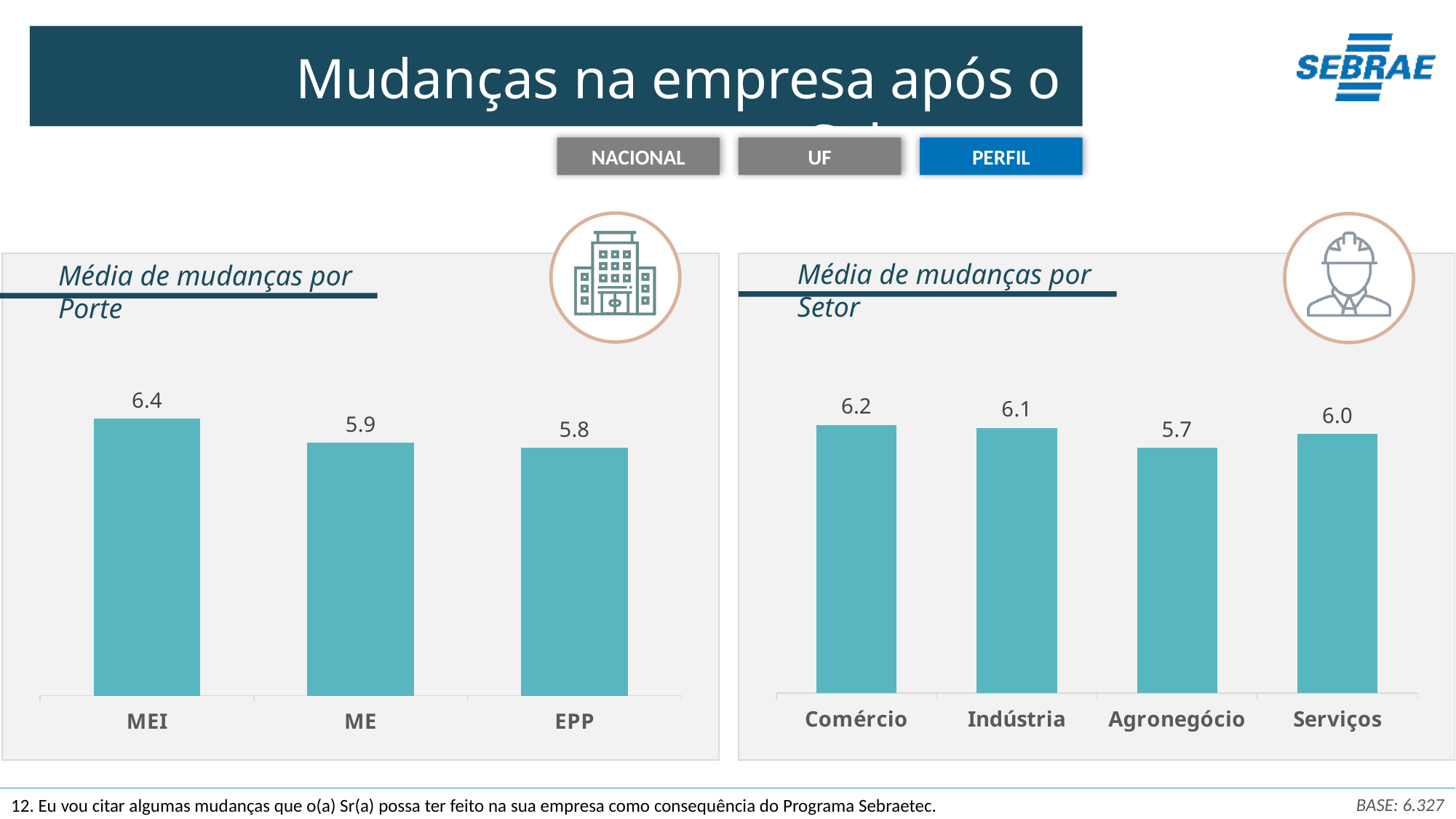
In the 'Média de mudanças por Porte' chart, how many categories are shown? 3 In the 'Média de mudanças por Setor' chart, what is the difference between the values for Comércio and Agronegócio? 0.5 What kind of chart is the 'Média de mudanças por Setor' chart? bar chart In the 'Média de mudanças por Setor' chart, which is larger, the value for Comércio or the value for Agronegócio? Comércio In the 'Média de mudanças por Porte' chart, do the values rise or fall from MEI to EPP? fall In the 'Média de mudanças por Porte' chart, what is the difference between the values for MEI and ME? 0.5 In the 'Média de mudanças por Setor' chart, what is the value for Agronegócio? 5.7 In the 'Média de mudanças por Porte' chart, what is the value for EPP? 5.8 In the 'Média de mudanças por Setor' chart, what is the value for Serviços? 6.0 In the 'Média de mudanças por Porte' chart, what is the value for MEI? 6.4 In the 'Média de mudanças por Porte' chart, which category has the highest value? MEI In the 'Média de mudanças por Setor' chart, which category has the lowest value? Agronegócio